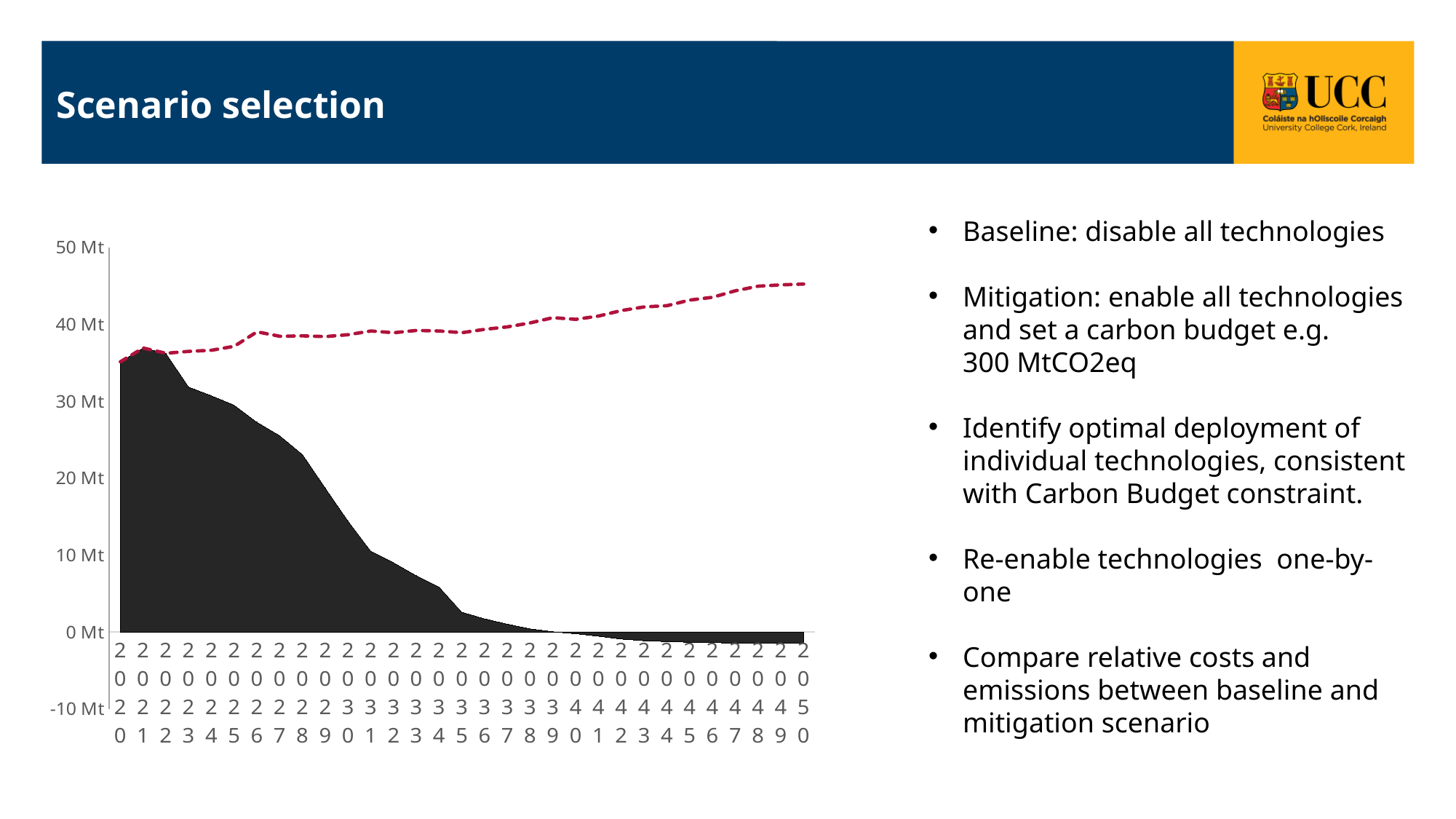
In 2040, which is higher: the red dashed line or the black shaded area? the red dashed line Is the value of the black shaded area in 2020 greater or less than 30 Mt? greater Is the value of the black shaded area in 2030 greater or less than 20 Mt? less What kind of chart is shown on the slide? area and line chart How many years are shown along the x axis of the chart? 31 In which year does the red dashed line reach its highest value? 2050 Is the value of the black shaded area in 2040 greater or less than 10 Mt? less What is the first year shown on the x axis of the chart? 2020 What is the last year shown on the x axis of the chart? 2050 Does the black shaded area rise or fall from 2020 to 2050? fall Does the red dashed line rise or fall from 2020 to 2050? rise